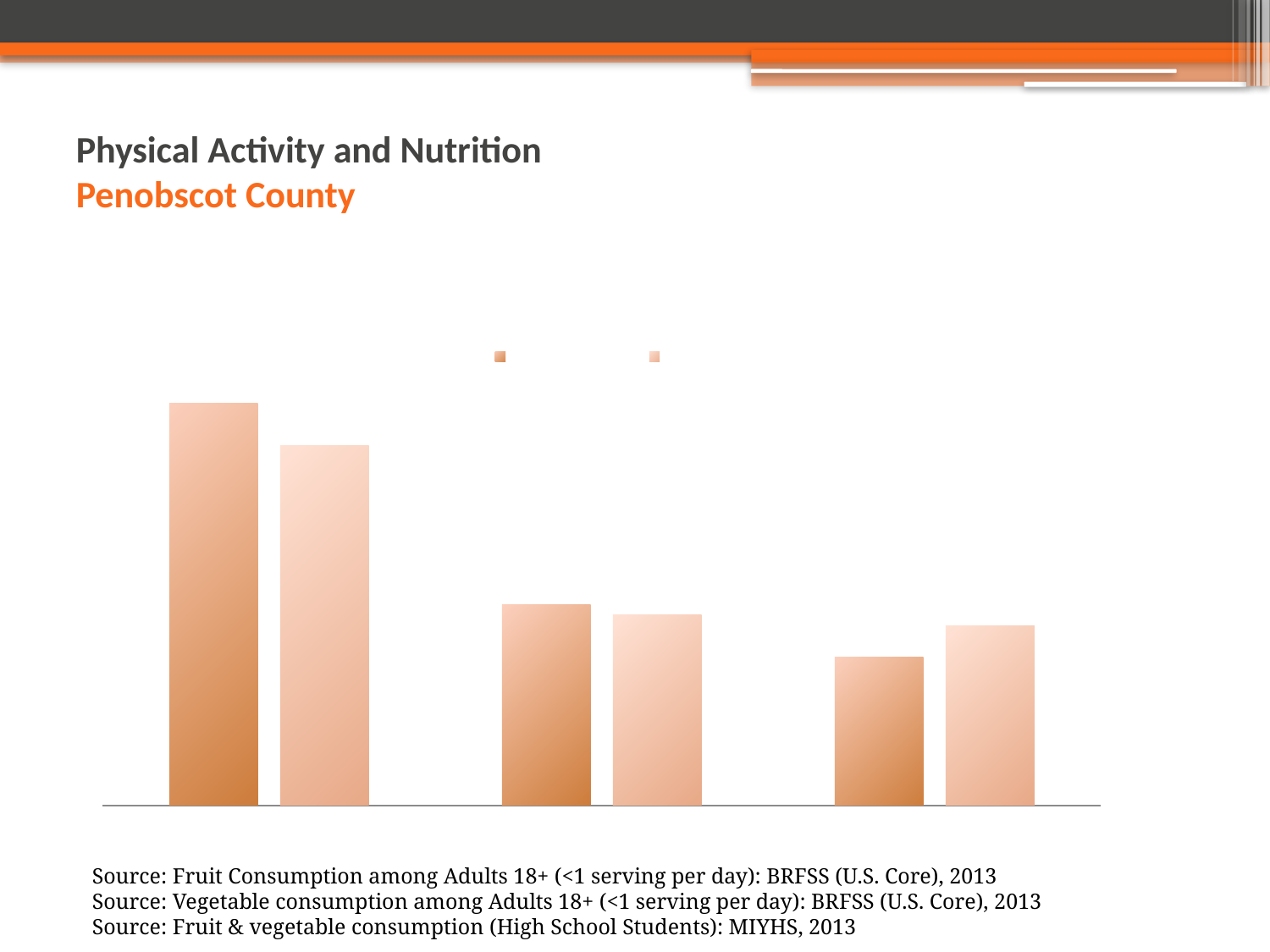
Is the darker bar in the middle group taller or shorter than the darker bar in the leftmost group? shorter In the leftmost group, is the darker bar or the lighter bar taller? darker bar Which group of bars is the shortest: the leftmost, middle, or rightmost? rightmost In the rightmost group, is the darker bar or the lighter bar taller? lighter bar Do the bar heights rise or fall from left to right across the groups? fall What kind of chart is shown on the slide? bar chart What is the main title of the slide? Physical Activity and Nutrition What is the subtitle shown in orange under the slide title? Penobscot County How many series does the legend list? 2 How many groups of bars are plotted on the chart? 3 How many bars are plotted in total on the chart? 6 Which group of bars is the tallest: the leftmost, middle, or rightmost? leftmost